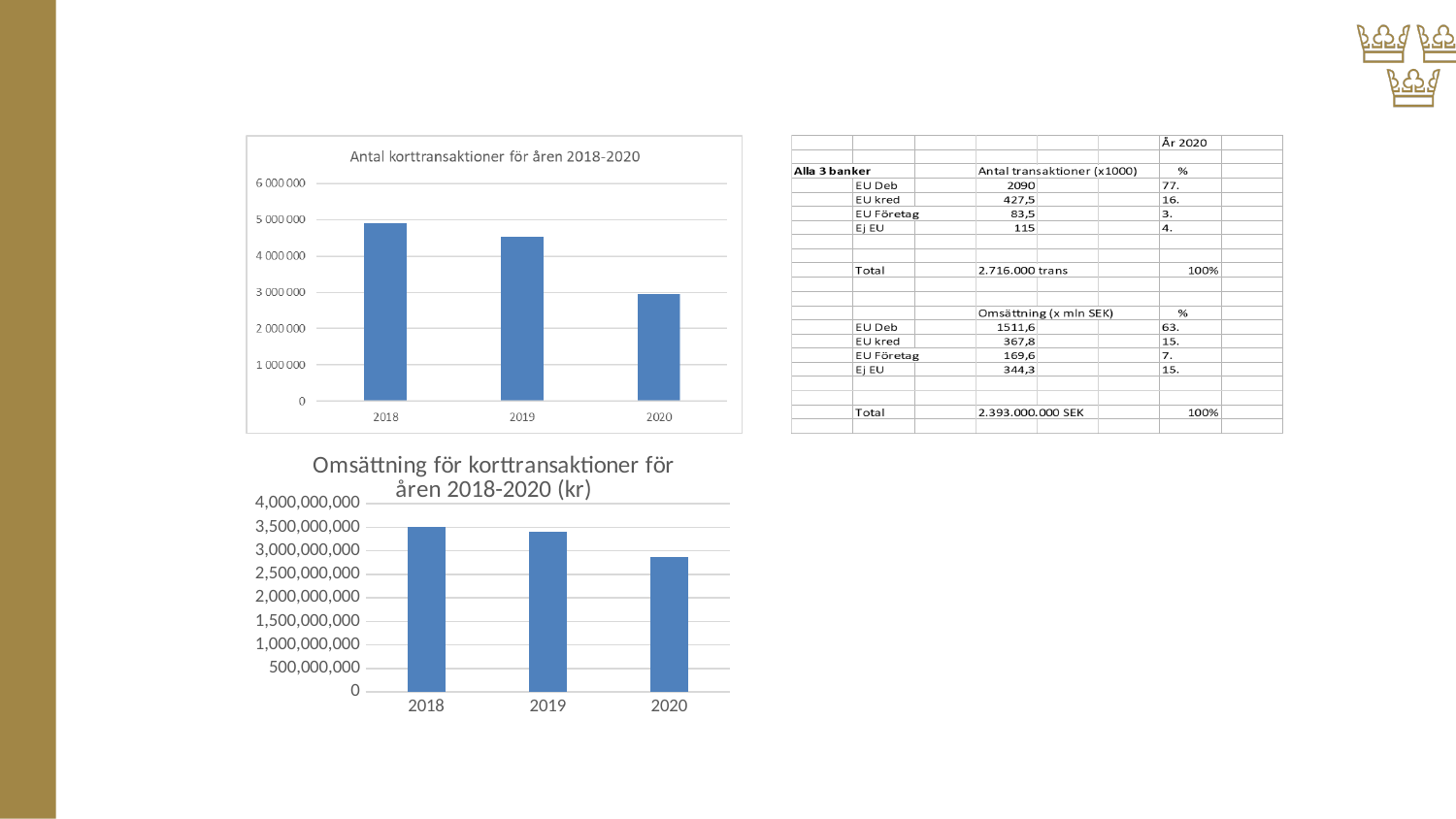
In the chart titled 'Antal korttransaktioner för åren 2018-2020', is the value for 2019 greater or less than 4 000 000? greater What is the title of the bottom-left chart on the slide? Omsättning för korttransaktioner för åren 2018-2020 (kr) What kind of chart is the chart titled 'Antal korttransaktioner för åren 2018-2020'? bar chart In the chart titled 'Antal korttransaktioner för åren 2018-2020', which year has the highest value? 2018 How many years are shown on the x axis of the chart titled 'Antal korttransaktioner för åren 2018-2020'? 3 In the chart titled 'Omsättning för korttransaktioner för åren 2018-2020 (kr)', which year has the lowest value? 2020 In the chart titled 'Antal korttransaktioner för åren 2018-2020', which year has the lowest value? 2020 In the chart titled 'Omsättning för korttransaktioner för åren 2018-2020 (kr)', which is larger, the value for 2018 or the value for 2020? 2018 In the chart titled 'Antal korttransaktioner för åren 2018-2020', do the values rise or fall from 2018 to 2020? fall In the chart titled 'Omsättning för korttransaktioner för åren 2018-2020 (kr)', is the value for 2018 greater or less than 3,000,000,000? greater In the chart titled 'Antal korttransaktioner för åren 2018-2020', is the value for 2020 greater or less than 3 000 000? less